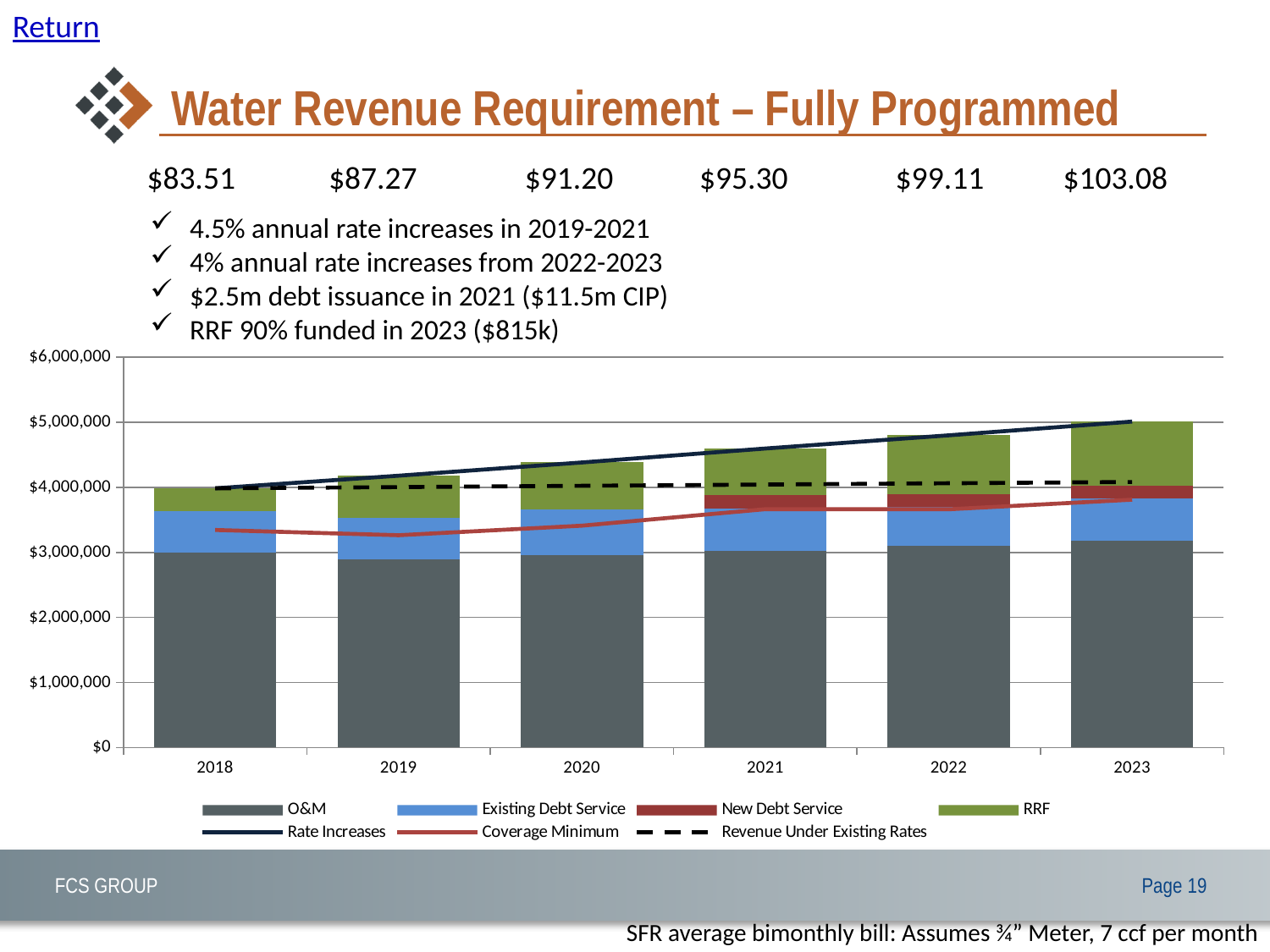
Which year has the tallest stacked bar? 2023 Which year has the shortest stacked bar? 2018 Which series is drawn as a dashed line in the chart? Revenue Under Existing Rates Is the total stacked bar for 2021 greater or less than $5,000,000? less Is the O&M value for 2023 greater or less than $3,000,000? greater Which is larger, the total stacked bar for 2023 or for 2018? 2023 What kind of chart is shown on the slide? Stacked bar chart with line series Is the total stacked bar for 2021 greater or less than $4,000,000? greater Does the Rate Increases line rise or fall from 2018 to 2023? rise How many series does the chart legend list? 7 How many years are shown on the x axis of the chart? 6